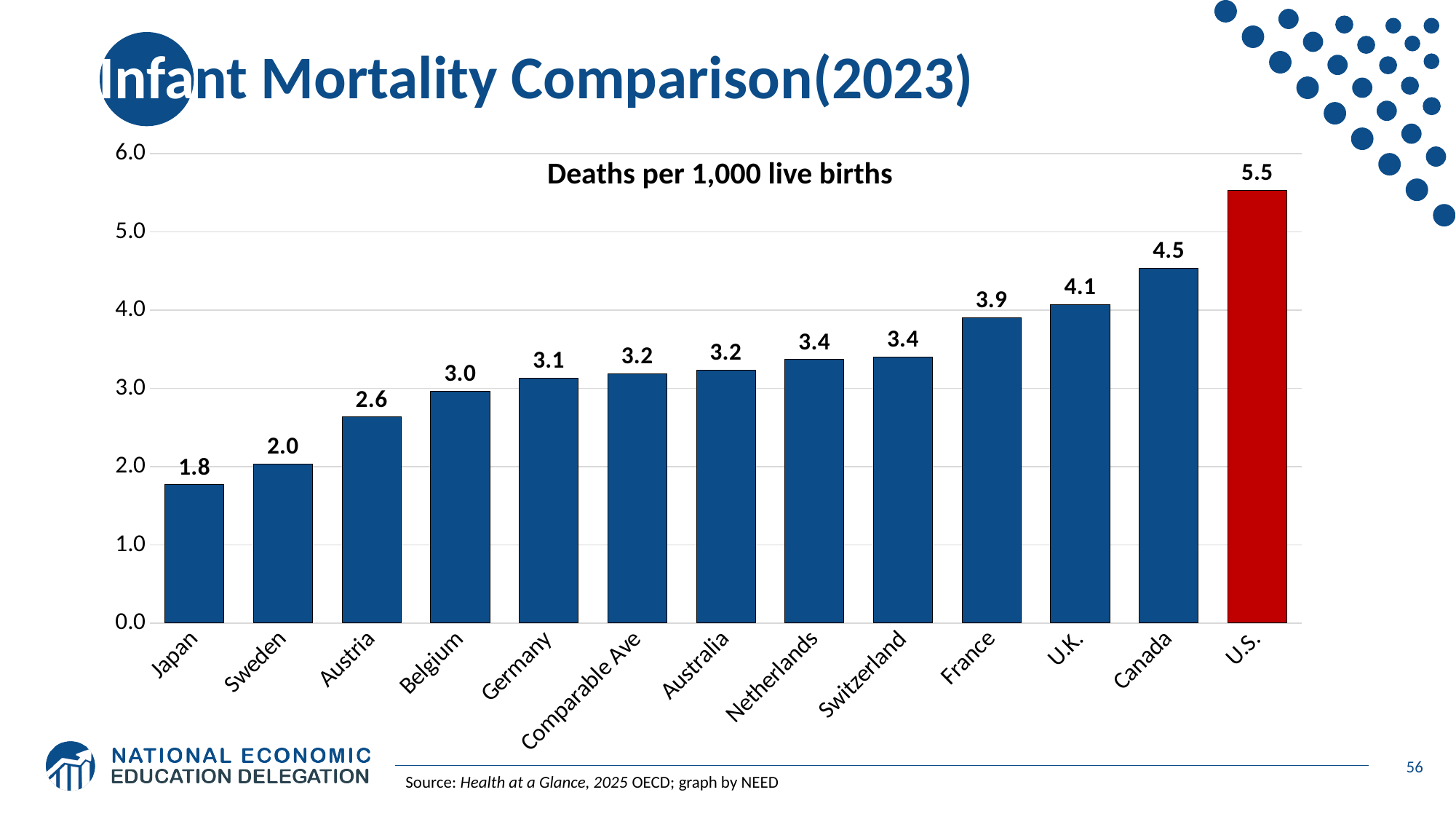
Which country has the lowest infant mortality rate on the chart? Japan What is the difference between the U.S. value and the Canada value? 1.0 Which bar is coloured red rather than blue? U.S. What is the value shown for the Comparable Ave bar? 3.2 Which country has the highest infant mortality rate on the chart? U.S. What is the value shown for the U.S.? 5.5 What is the infant mortality value for Japan? 1.8 How many bars are shown on the chart? 13 What kind of chart is shown on the slide? Bar chart Is the value for the U.K. greater or less than 4.0? greater Which has a higher value, France or Austria? France Do the values rise or fall moving from left to right along the x axis? Rise